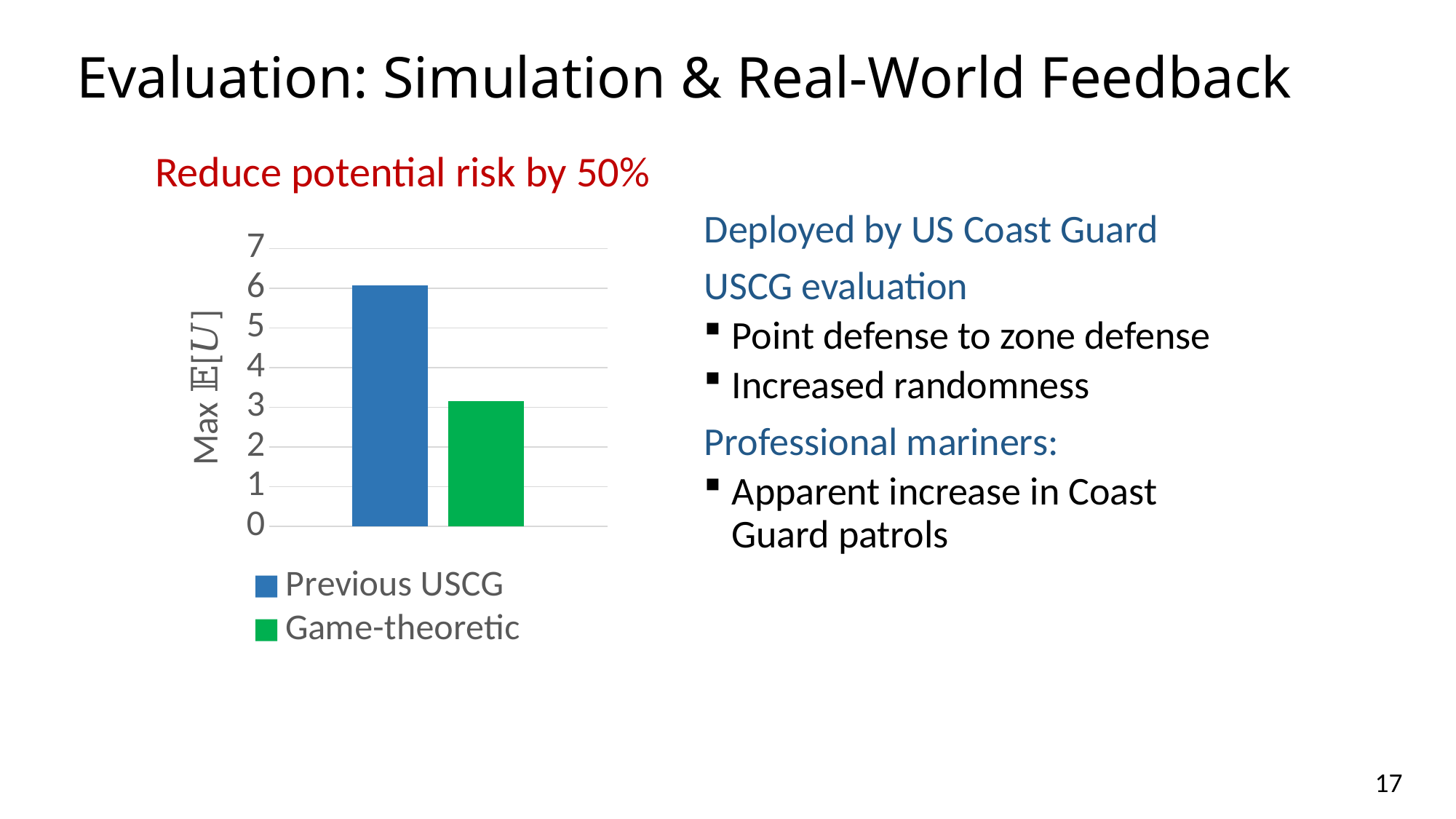
What colour is the bar for Game-theoretic in the chart? green What is the label on the vertical axis of the chart? Max E[U] How many series does the chart legend list? 2 Is the value for Game-theoretic greater or less than 2? greater Which series has the highest bar in the chart? Previous USCG Is the value for Game-theoretic greater or less than 4? less What kind of chart is shown on the slide? bar chart Is the value for Previous USCG greater or less than 5? greater Which is larger, the value for Previous USCG or the value for Game-theoretic? Previous USCG How many bars are plotted in the chart? 2 Which series has the lowest bar in the chart? Game-theoretic